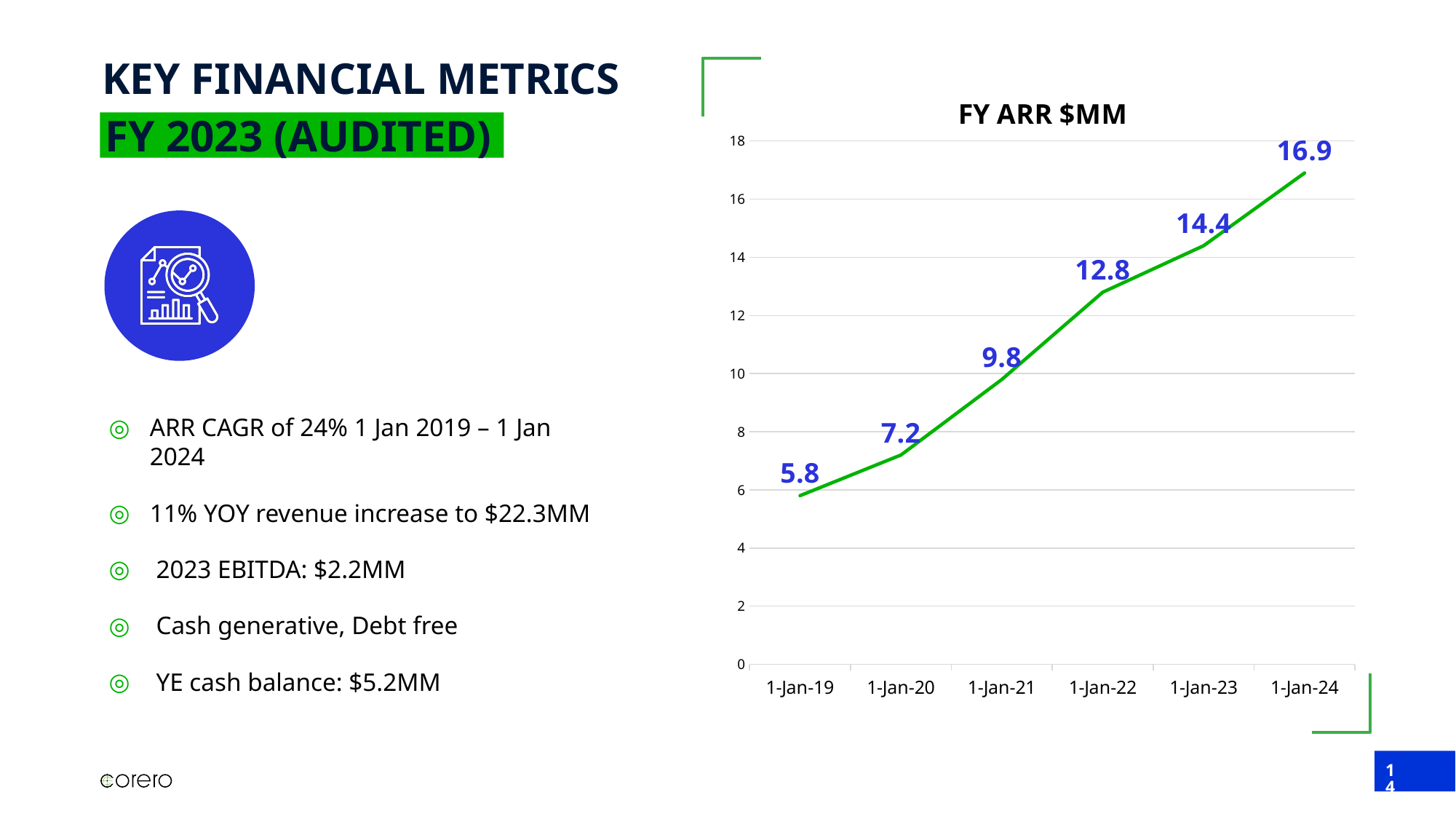
What is the difference between the values for 1-Jan-21 and 1-Jan-20 in the FY ARR $MM chart? 2.6 How many data points are plotted in the FY ARR $MM chart? 6 Is the value for 1-Jan-23 in the FY ARR $MM chart greater or less than 12? greater Do the values in the FY ARR $MM chart rise or fall from 1-Jan-19 to 1-Jan-24? rise What is the value for 1-Jan-19 in the FY ARR $MM chart? 5.8 What is the difference between the values for 1-Jan-24 and 1-Jan-23 in the FY ARR $MM chart? 2.5 What is the value for 1-Jan-22 in the FY ARR $MM chart? 12.8 Which date has the lowest value in the FY ARR $MM chart? 1-Jan-19 What is the value for 1-Jan-24 in the FY ARR $MM chart? 16.9 Which is larger in the FY ARR $MM chart, the value for 1-Jan-21 or 1-Jan-22? 1-Jan-22 What kind of chart is the FY ARR $MM chart? line chart Which date has the highest value in the FY ARR $MM chart? 1-Jan-24